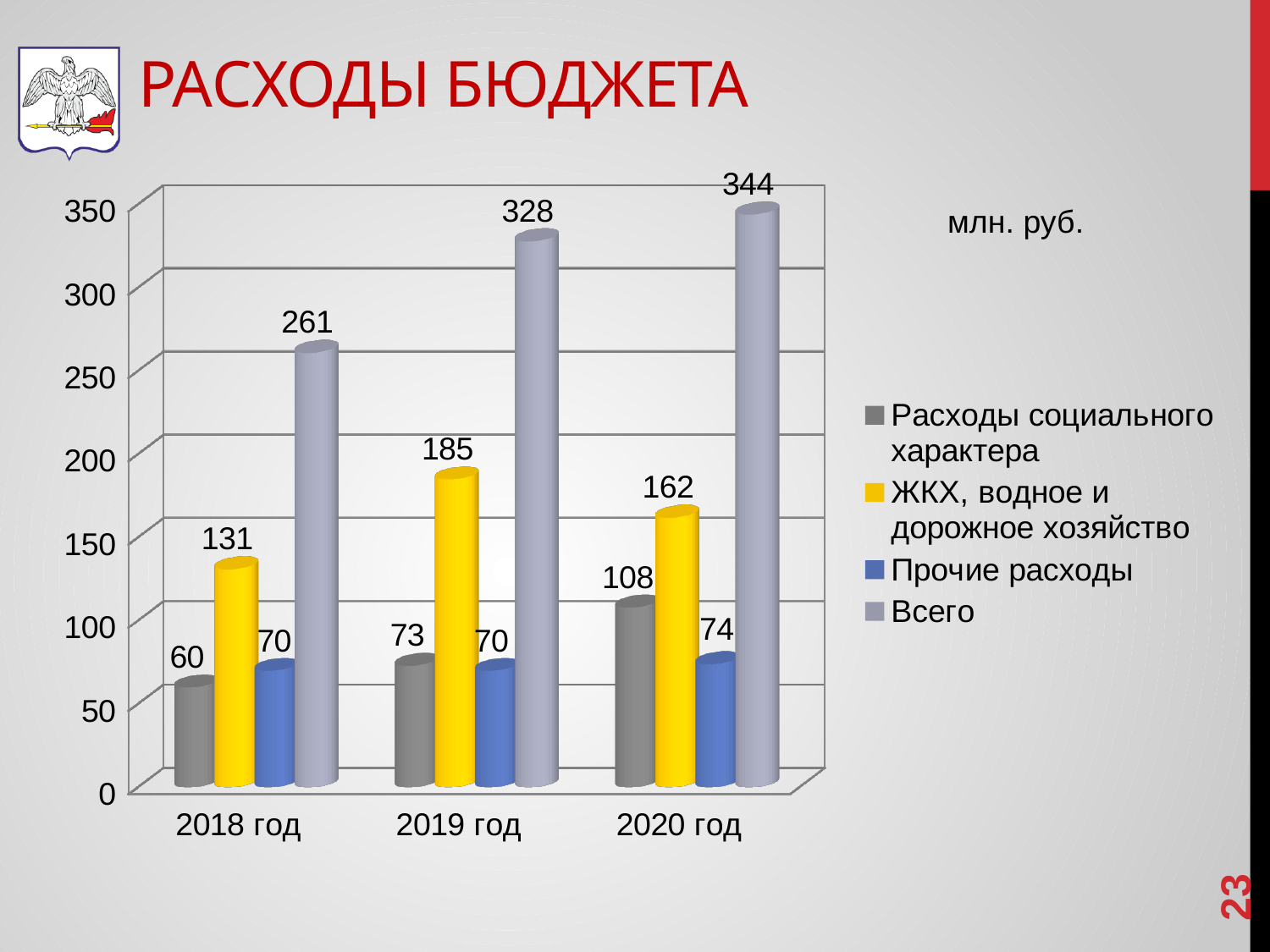
What is the value of «Прочие расходы» for 2020 год? 74 Which is larger: «ЖКХ, водное и дорожное хозяйство» for 2019 год or for 2020 год? 2019 год What is the value of «ЖКХ, водное и дорожное хозяйство» for 2019 год? 185 What is the difference between «Всего» for 2020 год and 2019 год? 16 What is the value of «Всего» for 2020 год? 344 What is the value of «Расходы социального характера» for 2018 год? 60 In which year is «Расходы социального характера» the lowest? 2018 год In which year is «Всего» the highest? 2020 год How many series does the legend list? 4 How many years are shown on the x axis? 3 Does «Всего» rise or fall from 2018 год to 2020 год? Rises What kind of chart is shown on the slide? Bar chart